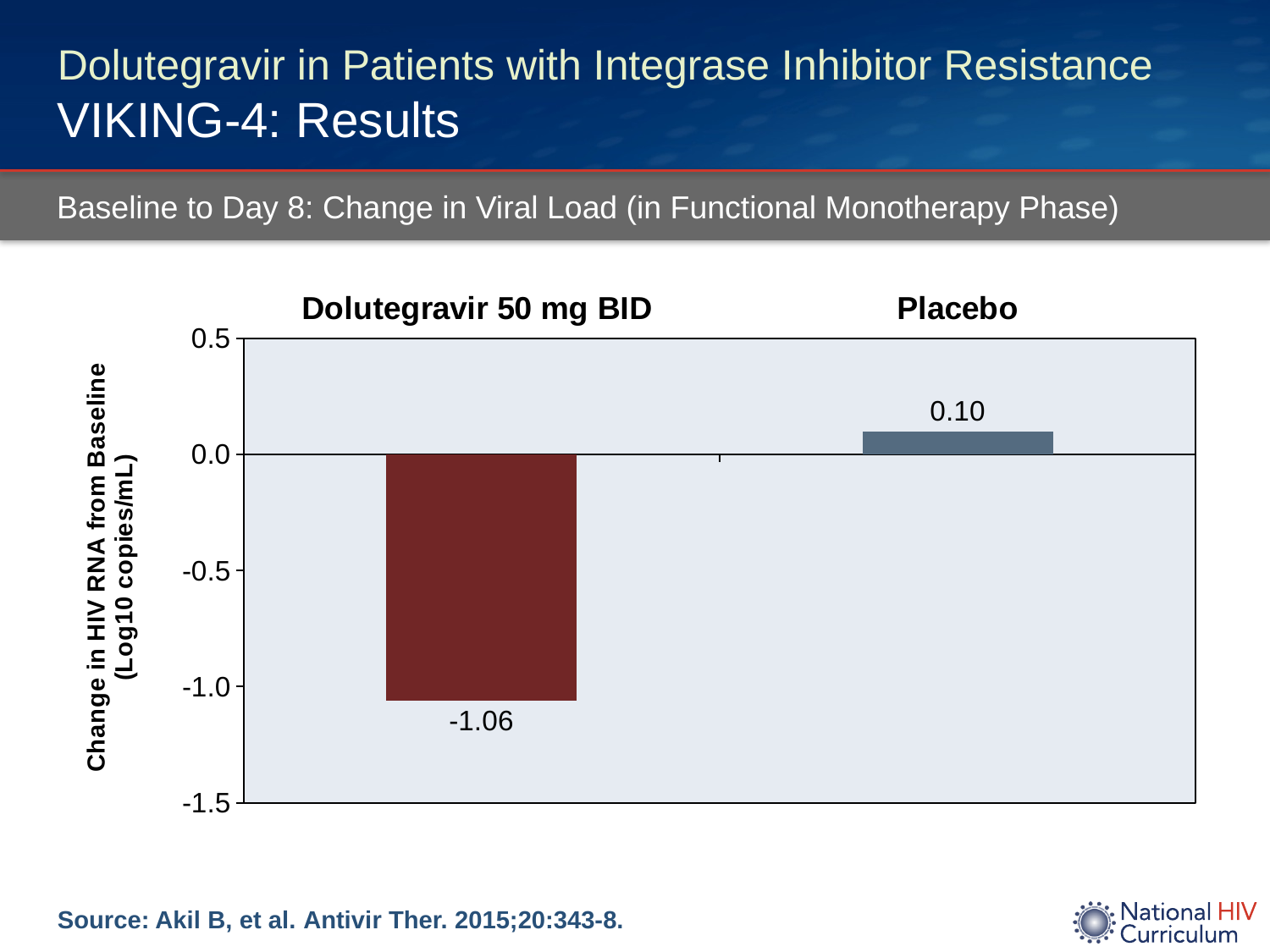
Which group has the lower change in HIV RNA from baseline? Dolutegravir 50 mg BID What is the difference between the Placebo value and the Dolutegravir 50 mg BID value? 1.16 Is the value for Dolutegravir 50 mg BID greater or less than the value for Placebo? less What is the change in HIV RNA from baseline for Placebo? 0.10 How many groups are plotted in the chart? 2 Which group has the higher change in HIV RNA from baseline? Placebo What is the change in HIV RNA from baseline for Dolutegravir 50 mg BID? -1.06 What is the label of the y axis? Change in HIV RNA from Baseline (Log10 copies/mL) What is the title of the chart? Baseline to Day 8: Change in Viral Load (in Functional Monotherapy Phase) What kind of chart is shown on the slide? Bar chart Is the value for Placebo greater or less than 0.0? greater Is the value for Dolutegravir 50 mg BID greater or less than -1.0? less